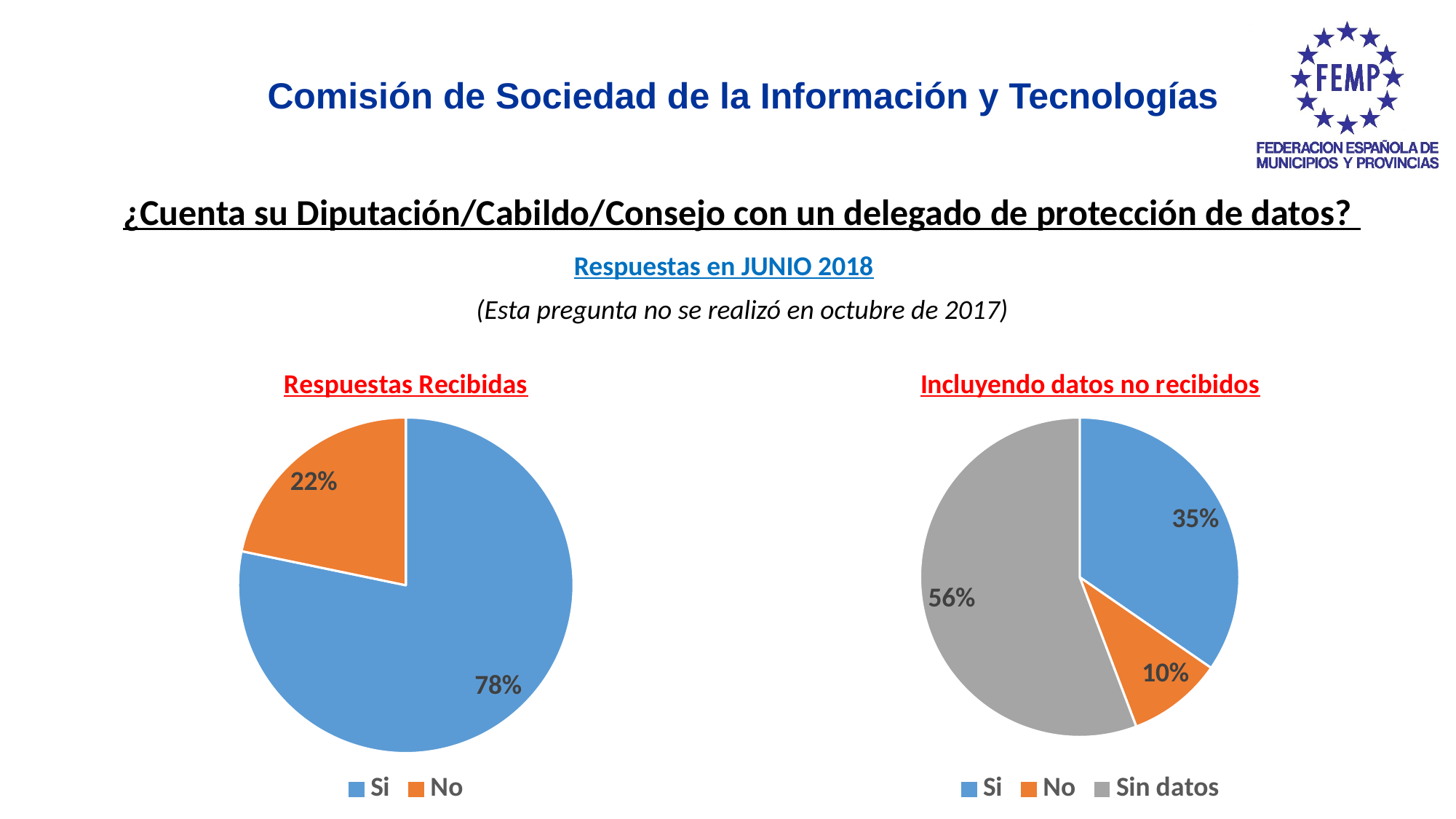
In the 'Respuestas Recibidas' chart, what percentage is shown for 'Si'? 78% In the 'Incluyendo datos no recibidos' chart, which category has the smallest slice? No What type of chart is the 'Respuestas Recibidas' chart? Pie chart How many slices does the 'Incluyendo datos no recibidos' chart have? 3 In the 'Incluyendo datos no recibidos' chart, which category has the largest slice? Sin datos In the 'Incluyendo datos no recibidos' chart, what percentage is shown for 'Sin datos'? 56% In the 'Incluyendo datos no recibidos' chart, which is larger, 'Si' or 'No'? Si In the 'Incluyendo datos no recibidos' chart, what colour is the 'Sin datos' slice? Grey In the 'Incluyendo datos no recibidos' chart, what percentage is shown for 'No'? 10% In the 'Respuestas Recibidas' chart, what is the difference in percentage points between 'Si' and 'No'? 56 How many entries does the legend of the 'Respuestas Recibidas' chart list? 2 In the 'Respuestas Recibidas' chart, what percentage is shown for 'No'? 22%